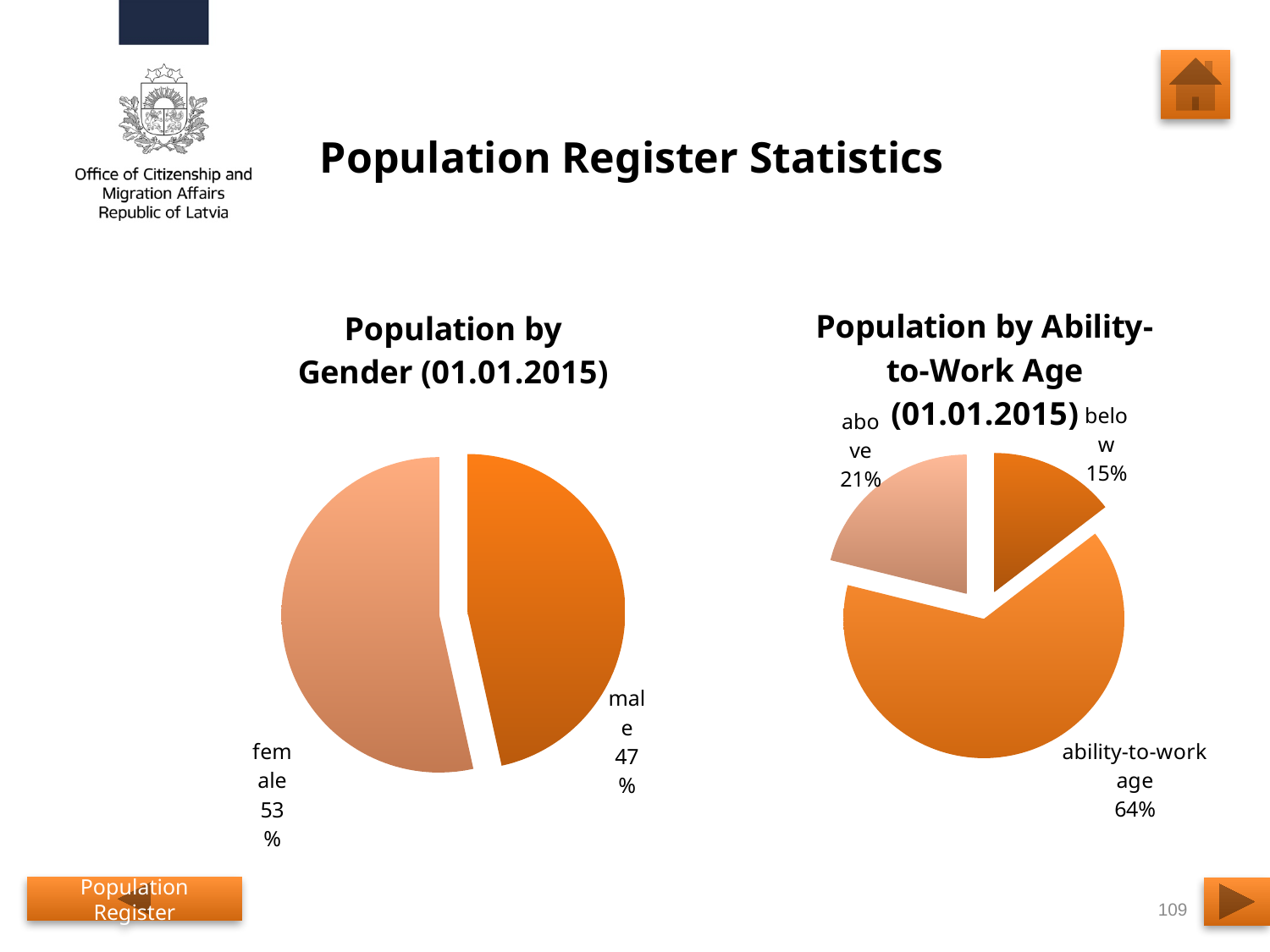
What kind of chart is the 'Population by Gender (01.01.2015)' chart? pie chart How many slices does the 'Population by Gender (01.01.2015)' chart have? 2 In the 'Population by Ability-to-Work Age (01.01.2015)' chart, which category has the largest share? ability-to-work age In the 'Population by Ability-to-Work Age (01.01.2015)' chart, what share is above ability-to-work age? 21% How many slices does the 'Population by Ability-to-Work Age (01.01.2015)' chart have? 3 In the 'Population by Ability-to-Work Age (01.01.2015)' chart, which category has the smallest share? below In the 'Population by Gender (01.01.2015)' chart, what share of the population is male? 47% In the 'Population by Ability-to-Work Age (01.01.2015)' chart, what share is below ability-to-work age? 15% In the 'Population by Gender (01.01.2015)' chart, which slice is larger, female or male? female In the 'Population by Gender (01.01.2015)' chart, what share of the population is female? 53% In the 'Population by Ability-to-Work Age (01.01.2015)' chart, what share is ability-to-work age? 64% In the 'Population by Gender (01.01.2015)' chart, what is the difference in percentage points between the female and male shares? 6